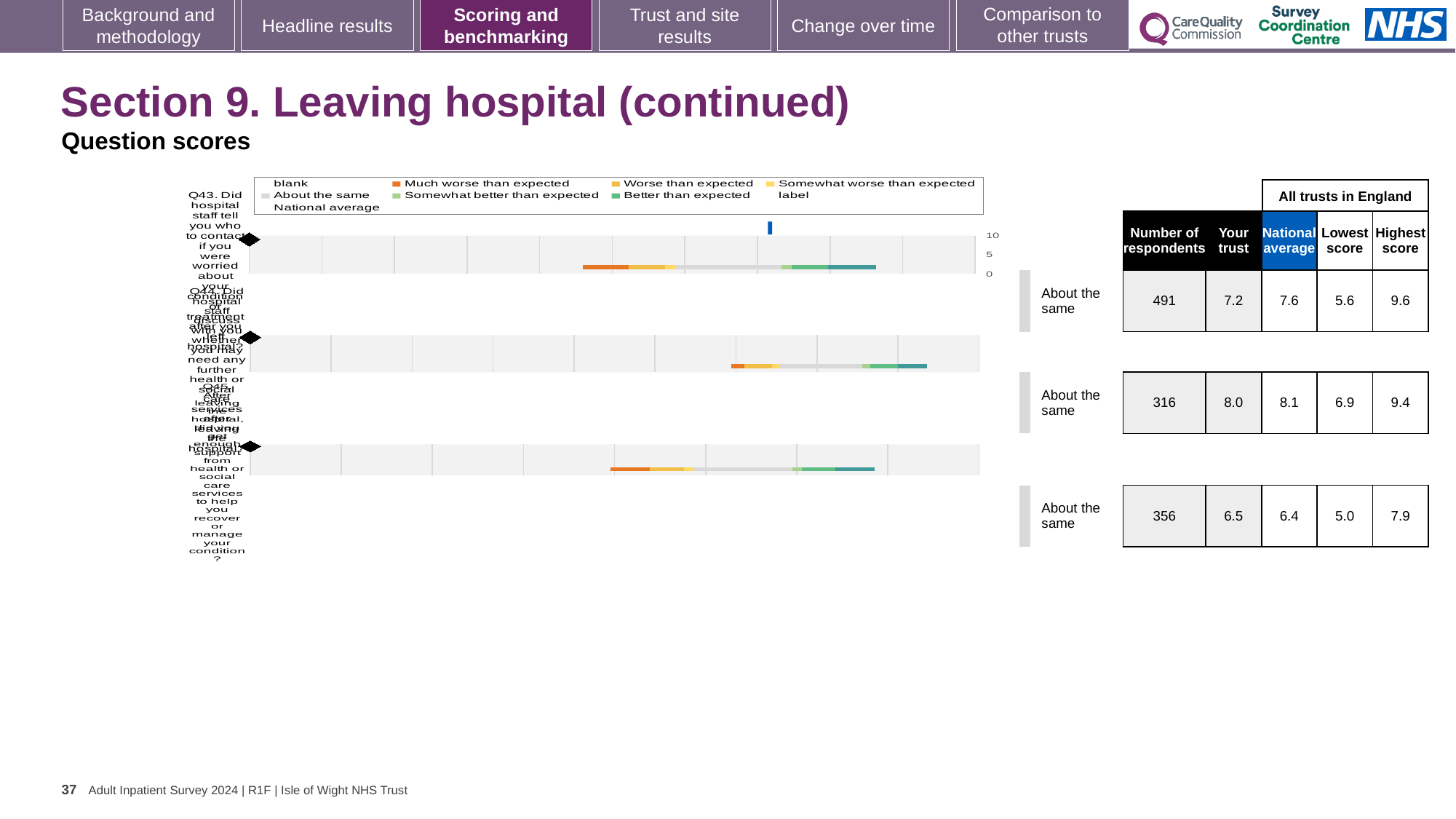
Which legend entry is shown in dark orange? Much worse than expected What kind of chart is used to show the question scores on this slide? bar chart Which question has the lowest 'Your trust' score? Q45 What is the 'Your trust' score for the first (top) question, Q43? 7.2 What is the lowest score across all trusts in England for Q44? 6.9 What is the national average score for the second question, Q44? 8.1 How many questions (rows) are plotted in the chart? 3 How many respondents answered the third question, Q45? 356 What benchmark category is shown next to each of the three questions? About the same Which question has the highest 'Your trust' score? Q44 For Q45, which is larger: the 'Your trust' score or the national average? Your trust For Q43, what is the difference between the highest score and the lowest score across all trusts in England? 4.0